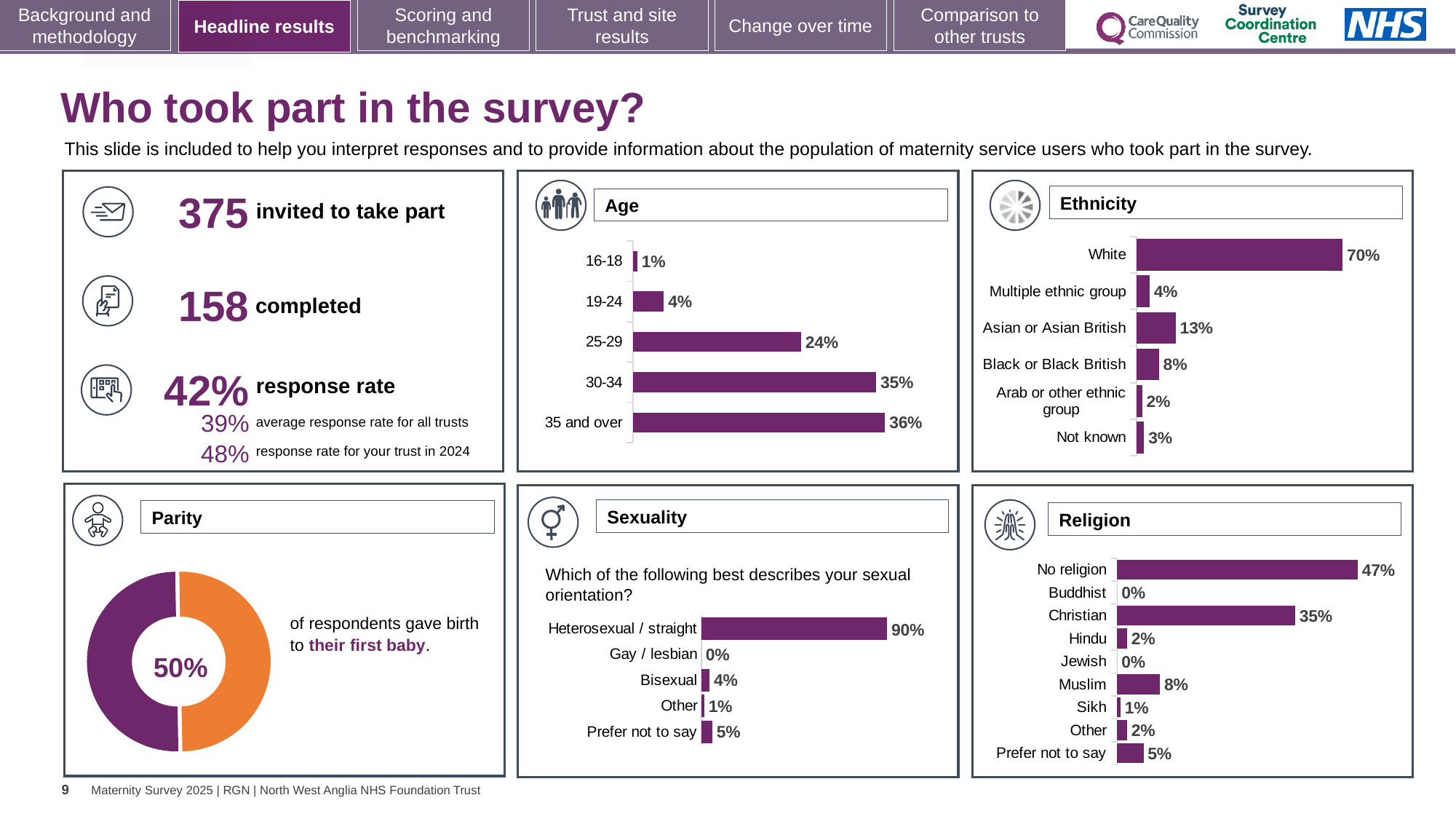
In the Religion chart, what percentage of respondents were Christian? 35% In the Ethnicity chart, what percentage of respondents were White? 70% In the Parity chart, what percentage of respondents gave birth to their first baby? 50% In the Ethnicity chart, what is the difference between Asian or Asian British and Black or Black British? 5% In the Age chart, which age group has the highest percentage? 35 and over What type of chart is used in the Parity panel? Doughnut chart In the Ethnicity chart, which category has the lowest percentage? Arab or other ethnic group In the Sexuality chart, what percentage of respondents answered Heterosexual / straight? 90% In the Age chart, what percentage of respondents were aged 30-34? 35% In the Religion chart, which is larger, Muslim or Hindu? Muslim In the Age chart, how many age categories are shown? 5 In the Religion chart, how many religion categories are listed? 9